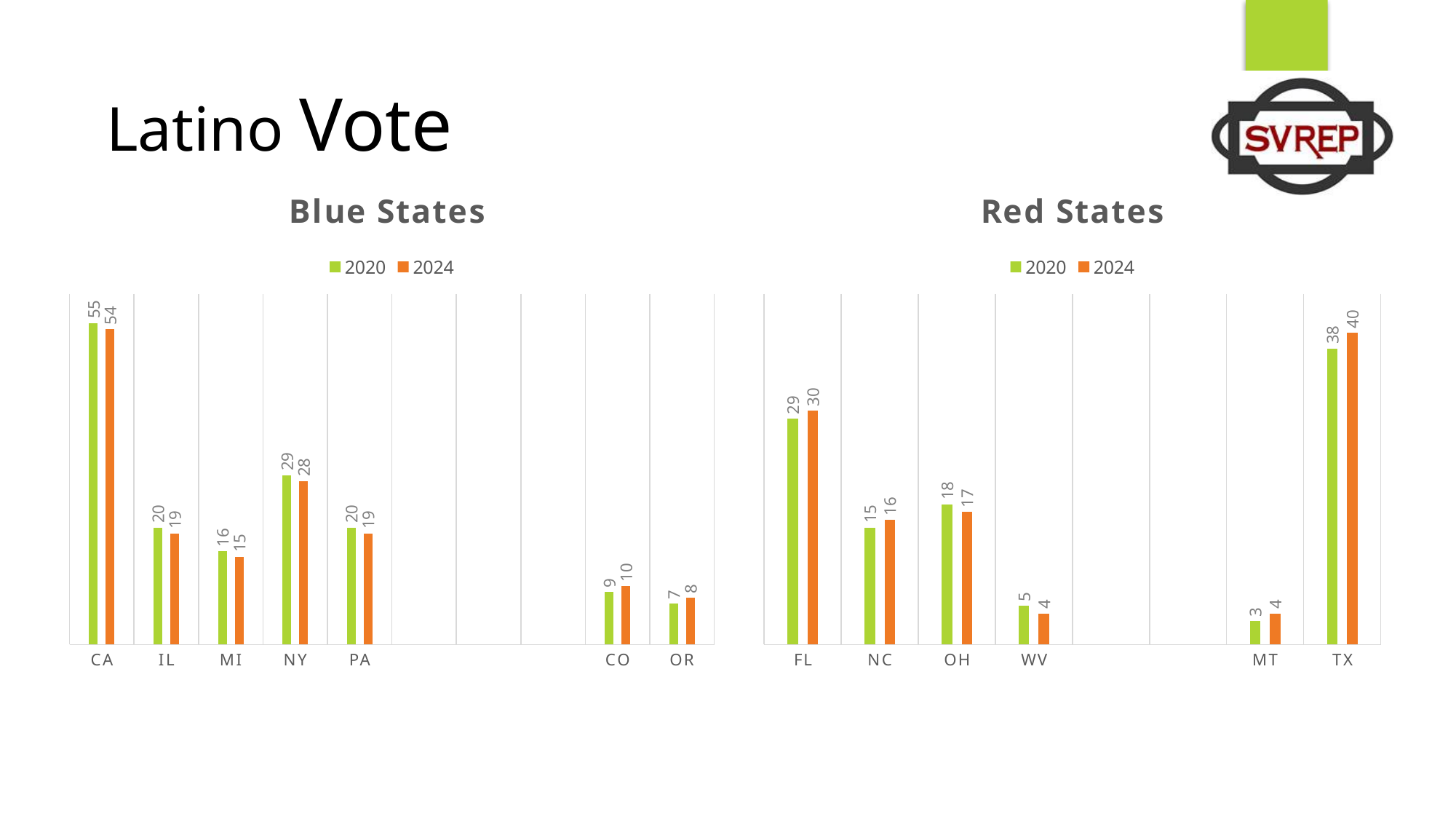
In the Blue States chart, what is the 2020 value for CA? 55 In the Red States chart, what is the difference between the 2024 and 2020 values for TX? 2 In the Blue States chart, which state has the highest 2020 value? CA In the Red States chart, what is the 2024 value for TX? 40 How many series does the legend of the Blue States chart list? 2 In the Red States chart, which state has the lowest 2020 value? MT In the Blue States chart, what is the difference between the 2020 values for CA and NY? 26 In the Blue States chart, what is the 2024 value for NY? 28 In the Red States chart, what is the 2020 value for WV? 5 In the Blue States chart, which colour represents the 2024 series? orange What kind of chart is the Red States chart? bar chart In the Red States chart, which is larger for FL: the 2020 value or the 2024 value? 2024